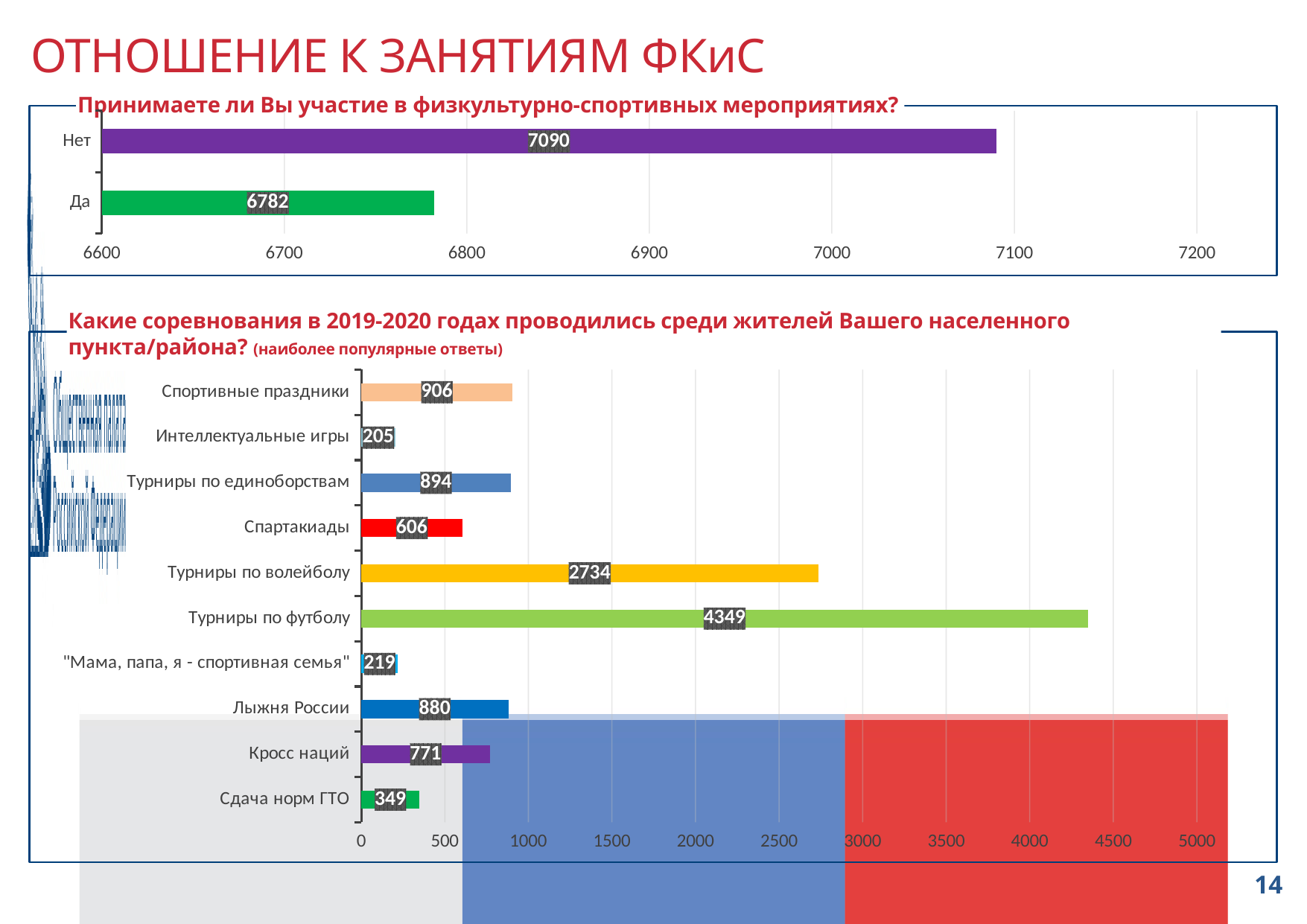
In the chart 'Принимаете ли Вы участие в физкультурно-спортивных мероприятиях?', what is the value for 'Да'? 6782 In the bottom chart about competitions held in 2019-2020, which category has the highest value? Турниры по футболу In the bottom chart about competitions held in 2019-2020, which is larger, 'Спортивные праздники' or 'Турниры по единоборствам'? Спортивные праздники In the chart 'Принимаете ли Вы участие в физкультурно-спортивных мероприятиях?', what is the value for 'Нет'? 7090 In the bottom chart about competitions held in 2019-2020, what is the difference between 'Турниры по футболу' and 'Турниры по волейболу'? 1615 In the bottom chart about competitions held in 2019-2020, what is the value for 'Сдача норм ГТО'? 349 What kind of chart is the top chart on the slide? Bar chart How many categories are shown in the bottom chart about competitions held in 2019-2020? 10 In the chart 'Принимаете ли Вы участие в физкультурно-спортивных мероприятиях?', which answer has the higher value, 'Нет' or 'Да'? Нет In the chart 'Принимаете ли Вы участие в физкультурно-спортивных мероприятиях?', what is the difference between the values for 'Нет' and 'Да'? 308 In the bottom chart about competitions held in 2019-2020, which category has the lowest value? Интеллектуальные игры In the bottom chart about competitions held in 2019-2020, what is the value for 'Турниры по футболу'? 4349